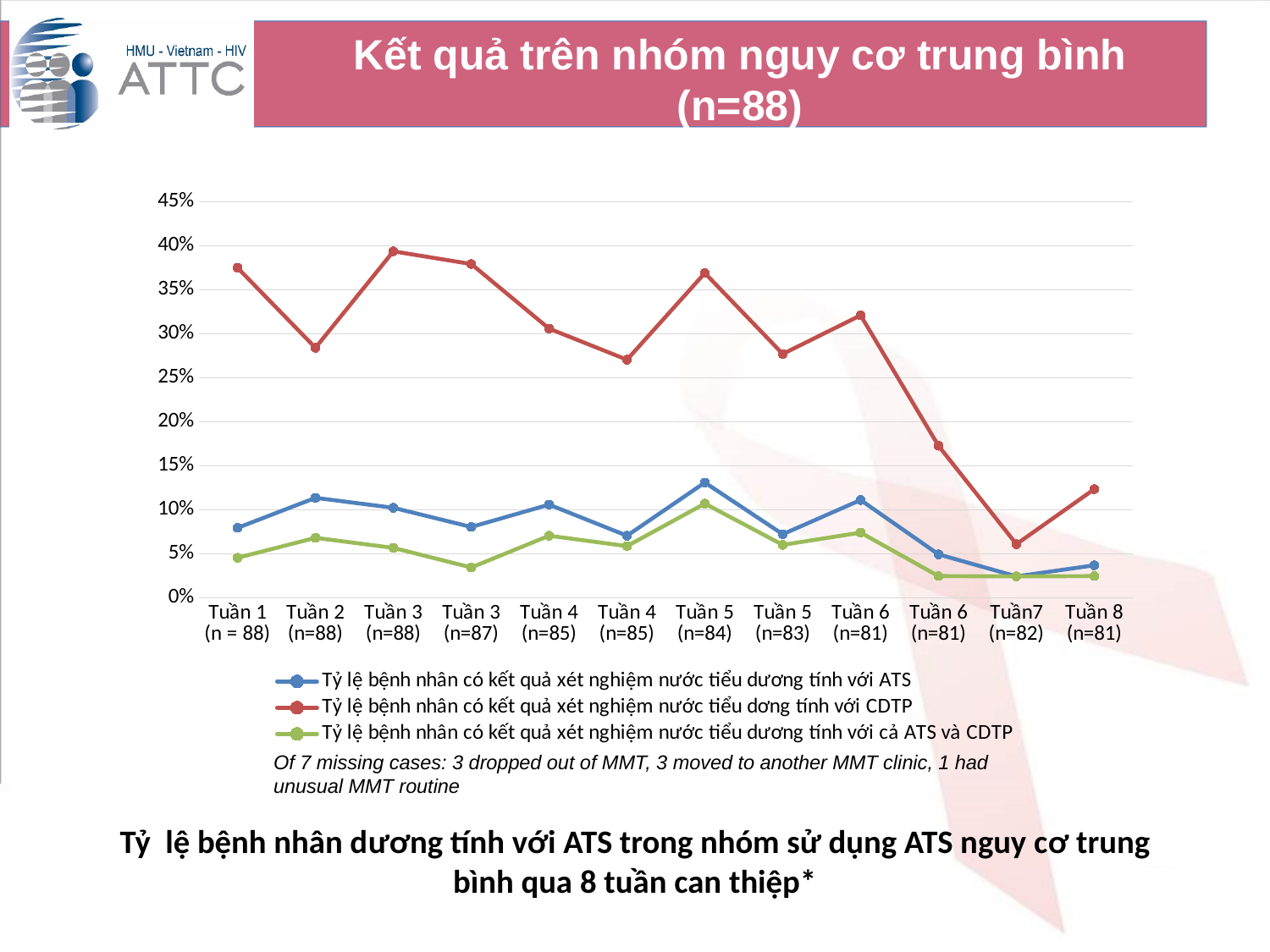
What is the title of the slide containing the chart? Kết quả trên nhóm nguy cơ trung bình (n=88) Is the value for the CDTP series at Tuần7 (n=82) greater or less than 10%? less Is the value for the ATS series at Tuần 5 (n=84) greater or less than 10%? greater At Tuần 1 (n = 88), which series has the larger value: ATS or CDTP? CDTP What kind of chart is shown on the slide? Line chart How many series does the legend list? 3 Is the value for the 'cả ATS và CDTP' series at Tuần 3 (n=87) greater or less than 5%? less Does the CDTP series overall rise or fall from Tuần 1 to Tuần 8? Fall At which x-axis point is the CDTP series (red line) at its lowest? Tuần7 (n=82) At which x-axis point is the ATS series (blue line) at its highest? Tuần 5 (n=84) How many points are plotted along the x axis for each series? 12